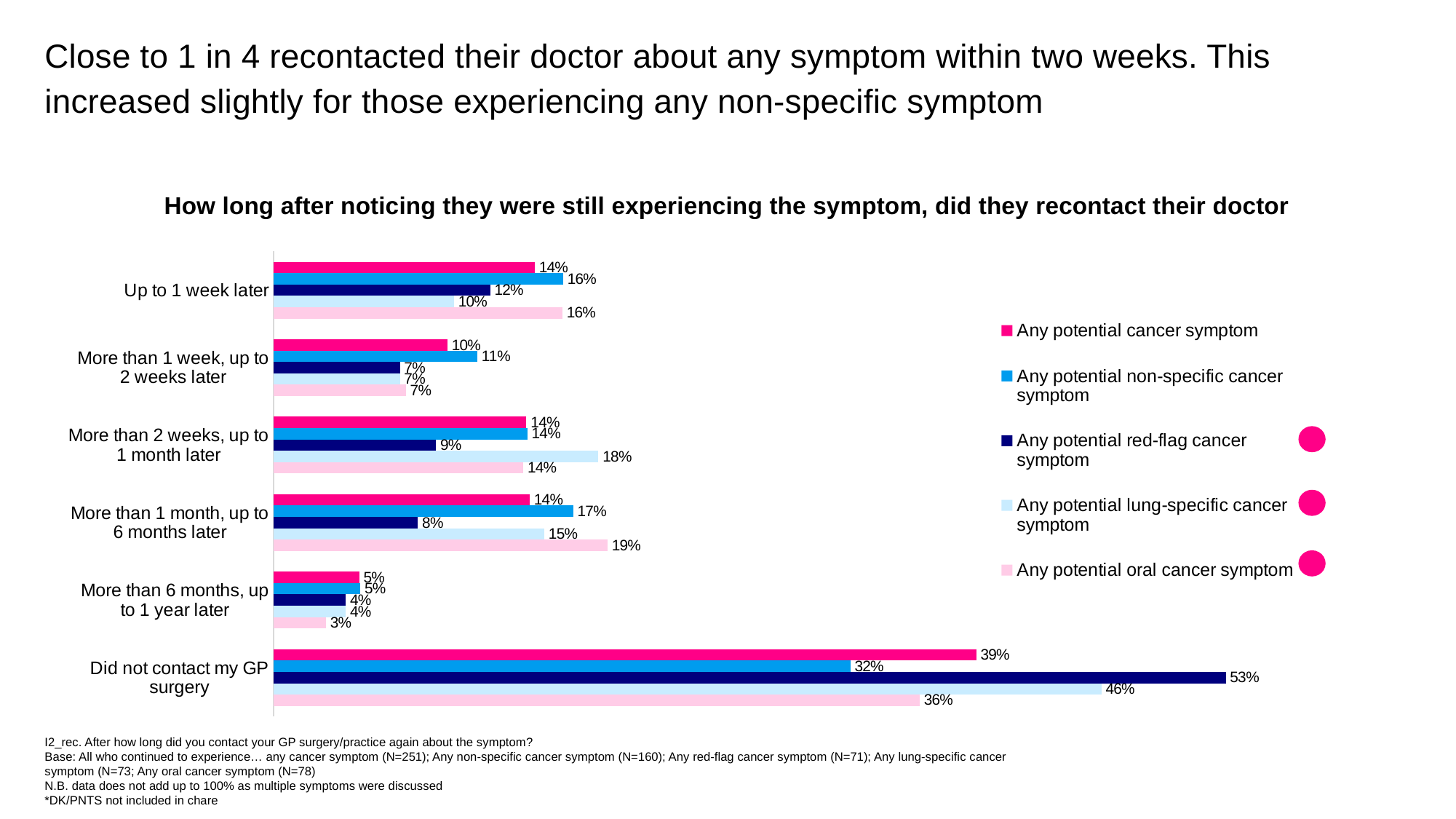
What is the value for 'Any potential oral cancer symptom' in the 'More than 1 month, up to 6 months later' category? 19% Which series has the lowest value in the 'More than 6 months, up to 1 year later' category? Any potential oral cancer symptom What is the title of the chart? How long after noticing they were still experiencing the symptom, did they recontact their doctor Which series has the highest value in the 'Did not contact my GP surgery' category? Any potential red-flag cancer symptom What is the value for 'Any potential lung-specific cancer symptom' in the 'Up to 1 week later' category? 10% How many series does the legend list? 5 What is the value for 'Any potential cancer symptom' in the 'More than 1 week, up to 2 weeks later' category? 10% What kind of chart is shown on the slide? Bar chart How many time-period categories are shown on the chart? 6 What is the difference between the 'Any potential red-flag cancer symptom' and 'Any potential non-specific cancer symptom' values in the 'Did not contact my GP surgery' category? 21% What is the value for 'Any potential red-flag cancer symptom' in the 'Did not contact my GP surgery' category? 53% In the 'More than 2 weeks, up to 1 month later' category, which is larger: 'Any potential lung-specific cancer symptom' or 'Any potential red-flag cancer symptom'? Any potential lung-specific cancer symptom